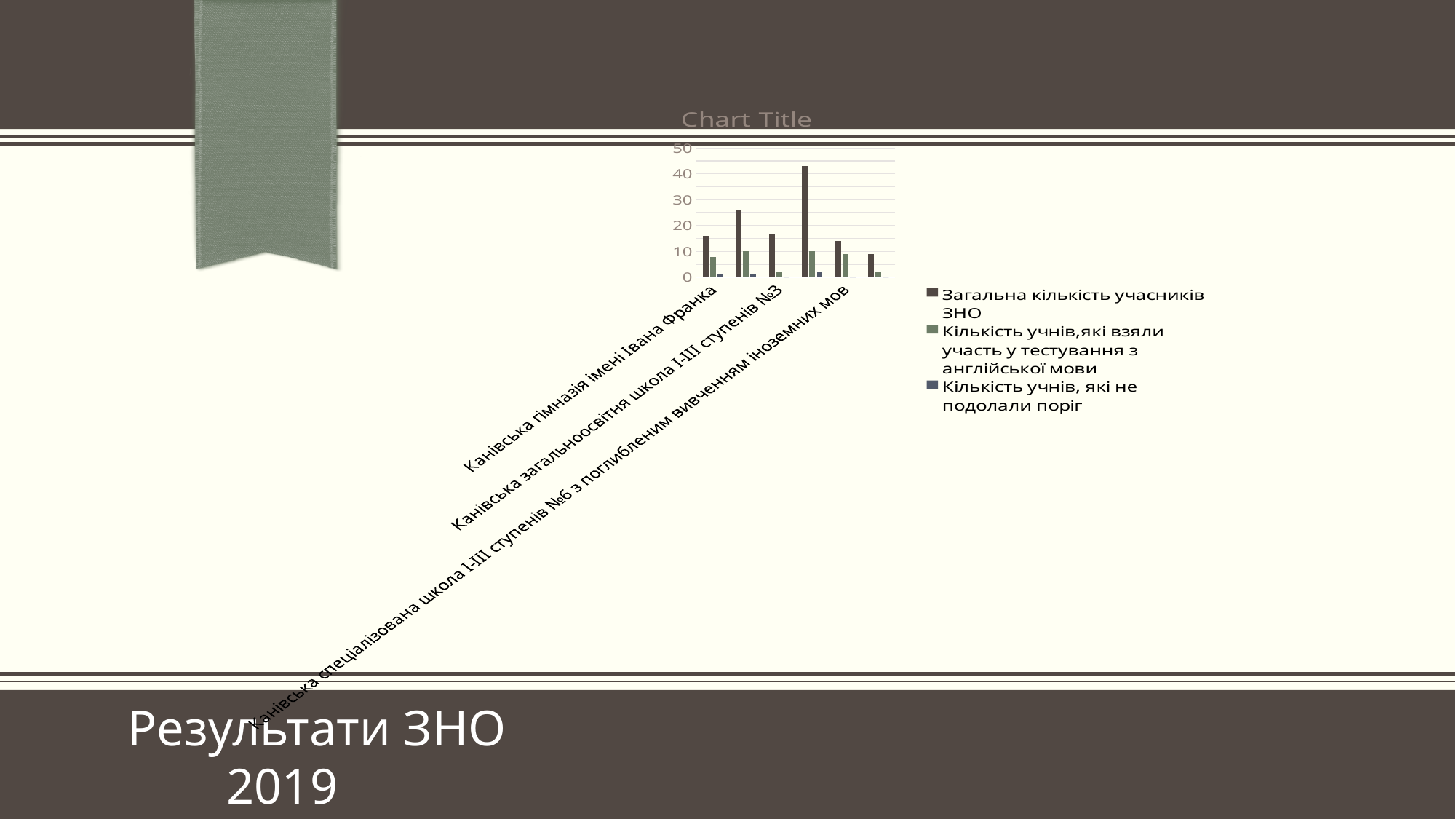
What kind of chart is shown on the slide? Bar chart How many series does the chart legend list? 3 Which is larger: the 'Загальна кількість учасників ЗНО' bar in the second group or in the first group from the left? The second group What is the title shown above the chart? Chart Title Is the 'Загальна кількість учасників ЗНО' bar in the first group from the left greater or less than 20? less How many groups of bars are plotted along the x axis? 6 Is the tallest 'Загальна кількість учасників ЗНО' bar greater or less than 40? greater Which group of bars (counting from the left) has the tallest bar for 'Загальна кількість учасників ЗНО'? The fourth group Which series has the smallest bars in every group? Кількість учнів, які не подолали поріг Is the 'Загальна кількість учасників ЗНО' bar in the second group from the left greater or less than 20? greater What is the first series listed in the chart legend? Загальна кількість учасників ЗНО